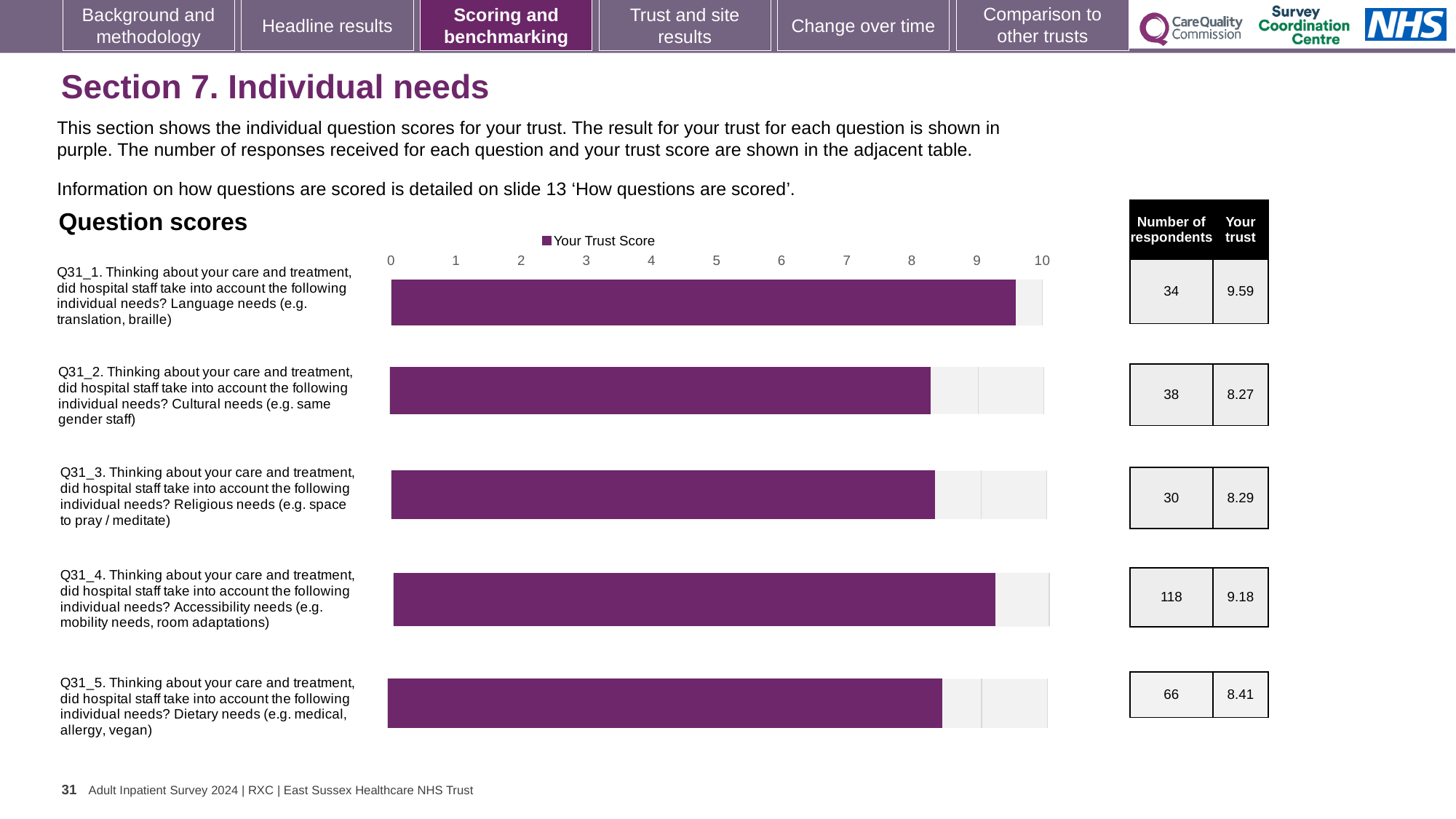
Which question has the highest trust score? Q31_1 (Language needs) Which has the larger trust score, Q31_1 (Language needs) or Q31_4 (Accessibility needs)? Q31_1 (Language needs) What is the trust score for Q31_1 (Language needs)? 9.59 What kind of chart is shown on the slide? bar chart What is the trust score for Q31_5 (Dietary needs)? 8.41 What is the trust score for Q31_4 (Accessibility needs)? 9.18 How many questions are plotted in the chart? 5 What is the name of the series shown in the chart legend? Your Trust Score How many series does the chart legend list? 1 What is the difference between the trust scores for Q31_1 (Language needs) and Q31_2 (Cultural needs)? 1.32 How many respondents answered Q31_4 (Accessibility needs)? 118 Is the trust score for Q31_2 (Cultural needs) greater or less than 9? less